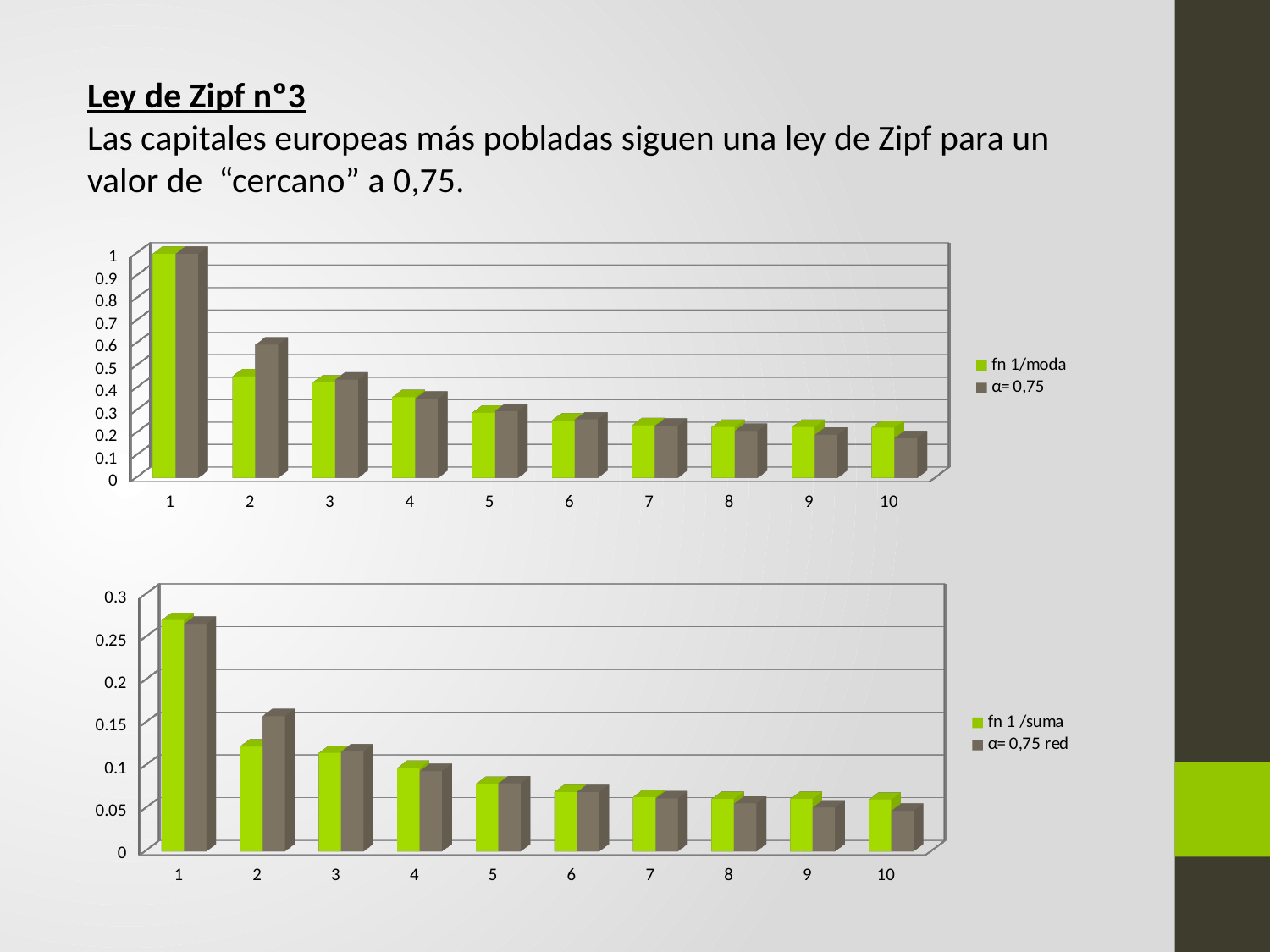
In the top chart, which category has the highest value for fn 1/moda? 1 In the top chart, how many series does the legend list? 2 In the top chart, is the value of fn 1/moda for category 10 greater or less than 0.3? less In the top chart, is the value of α= 0,75 for category 2 greater or less than 0.5? greater In the bottom chart, how many categories are shown on the x axis? 10 In the bottom chart, is the value of fn 1 /suma for category 1 greater or less than 0.25? greater In the top chart, for category 10, which series has the larger value, fn 1/moda or α= 0,75? fn 1/moda What kind of chart is the top chart? bar chart In the top chart, what is the value of fn 1/moda for category 1? 1 In the top chart, for category 2, which series has the larger value, fn 1/moda or α= 0,75? α= 0,75 In the bottom chart, what are the two legend entries? fn 1 /suma and α= 0,75 red In the bottom chart, do the values of fn 1 /suma rise or fall from category 1 to category 10? fall